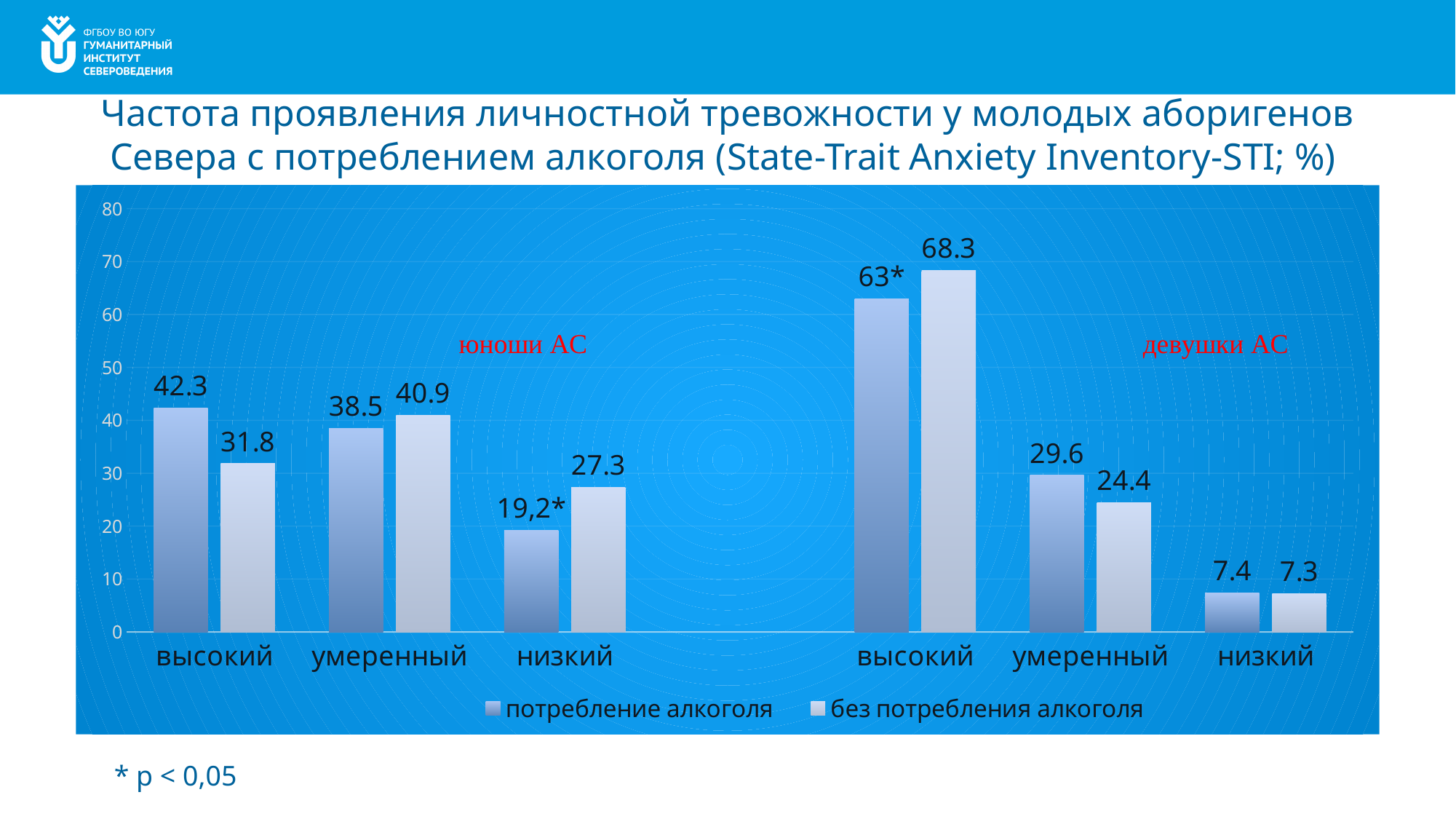
How many series does the legend list? 2 What is the value for "умеренный" in the "девушки АС" group for the "без потребления алкоголя" series? 24.4 What kind of chart is shown on the slide? bar chart Is the "без потребления алкоголя" value for "высокий" in the "девушки АС" group greater or less than 60? greater What is the value for "высокий" in the "юноши АС" group for the "потребление алкоголя" series? 42.3 Which category in the "юноши АС" group has the lowest value for the "без потребления алкоголя" series? низкий What is the value for "высокий" in the "девушки АС" group for the "без потребления алкоголя" series? 68.3 What is the difference between the "потребление алкоголя" and "без потребления алкоголя" values for "высокий" in the "юноши АС" group? 10.5 What is the value for "низкий" in the "юноши АС" group for the "без потребления алкоголя" series? 27.3 Which series is shown in the lighter colour in the legend? без потребления алкоголя For "умеренный" in the "юноши АС" group, which series has the larger value: "потребление алкоголя" or "без потребления алкоголя"? без потребления алкоголя Which category in the "девушки АС" group has the highest value for the "потребление алкоголя" series? высокий